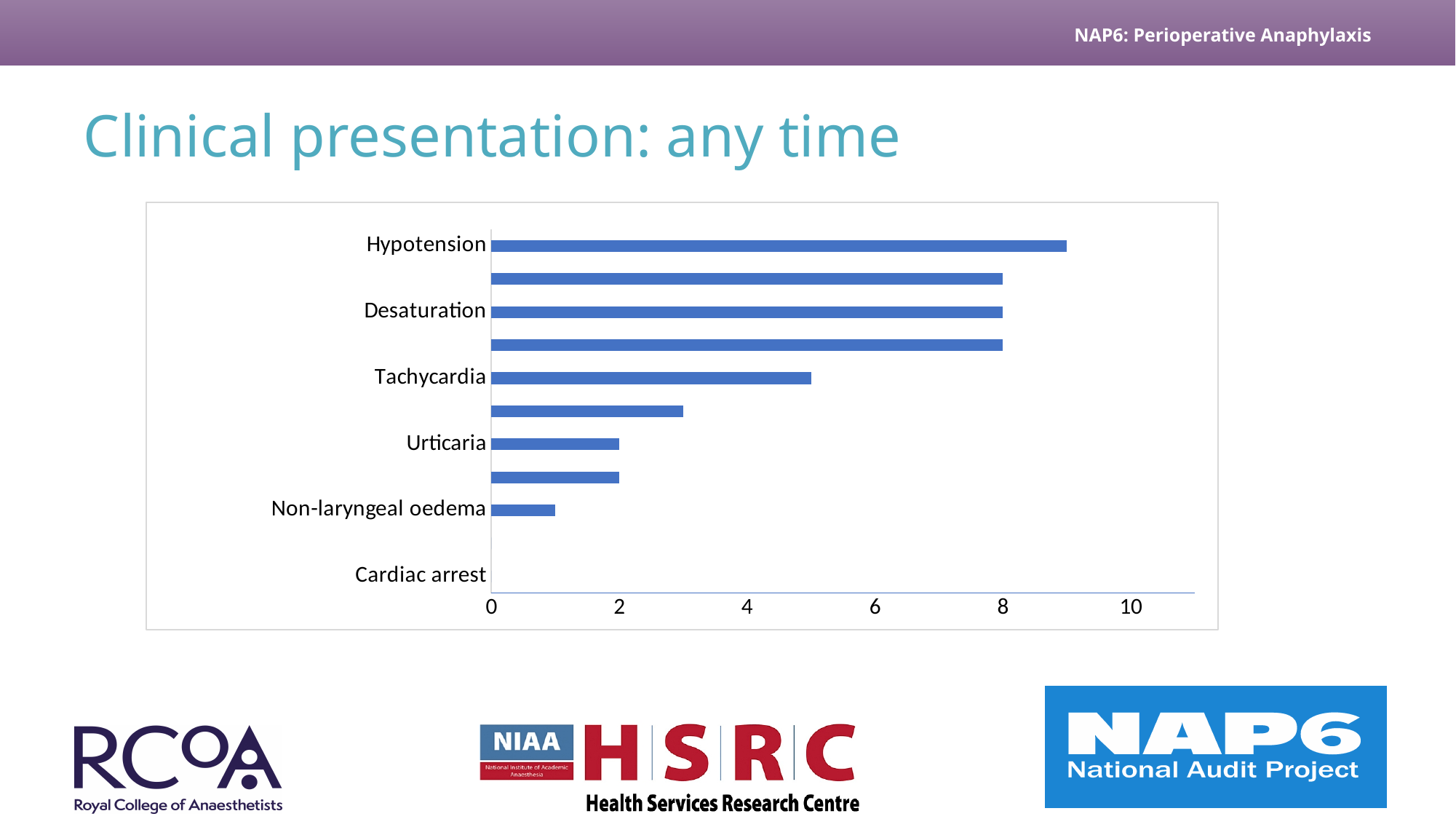
What is the value for Urticaria? 2 Which is larger, the value for Tachycardia or the value for Urticaria? Tachycardia Which labelled clinical presentation has the lowest value? Cardiac arrest Is the value for Tachycardia greater or less than 4? greater What kind of chart is shown on the slide? bar chart What is the difference between the values for Desaturation and Urticaria? 6 Is the value for Non-laryngeal oedema greater or less than 2? less Which labelled clinical presentation has the longest bar? Hypotension What is the highest tick value shown on the horizontal axis? 10 How many category labels are shown on the vertical axis of the chart? 6 What is the value for Desaturation? 8 Is the value for Hypotension greater or less than 8? greater